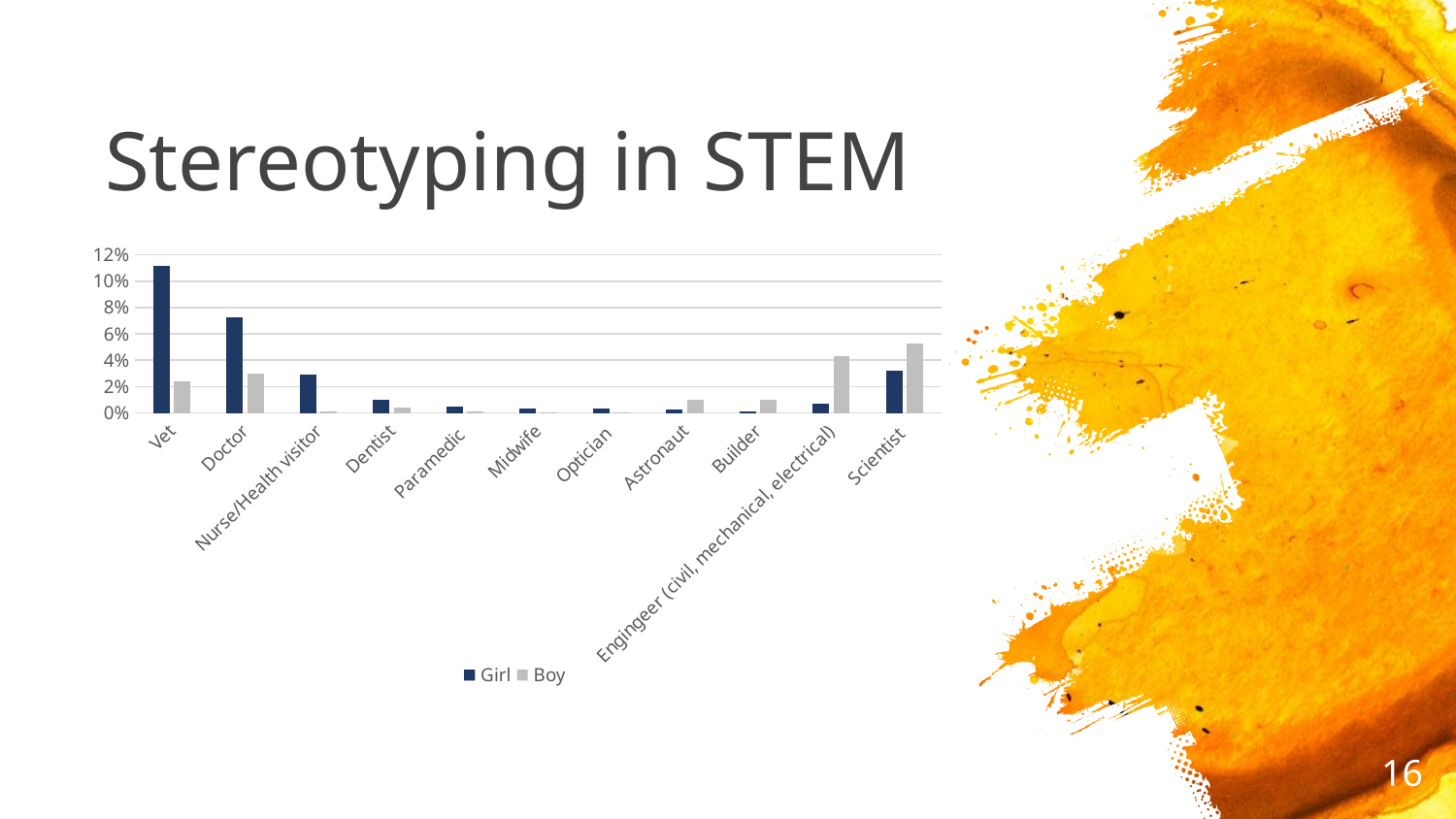
Is the Boy value for Nurse/Health visitor greater or less than 2%? less For Engineer (civil, mechanical, electrical), which series has the larger value, Girl or Boy? Boy Which occupation has the highest value for the Boy series? Scientist Is the Girl value for Doctor greater or less than 6%? greater How many series does the chart legend list? 2 What is the title of the slide containing the chart? Stereotyping in STEM What kind of chart is shown on the slide? bar chart Which occupation has the highest value for the Girl series? Vet For Vet, which series has the larger value, Girl or Boy? Girl How many occupation categories are shown on the x axis of the chart? 11 Is the Girl value for Vet greater or less than 10%? greater